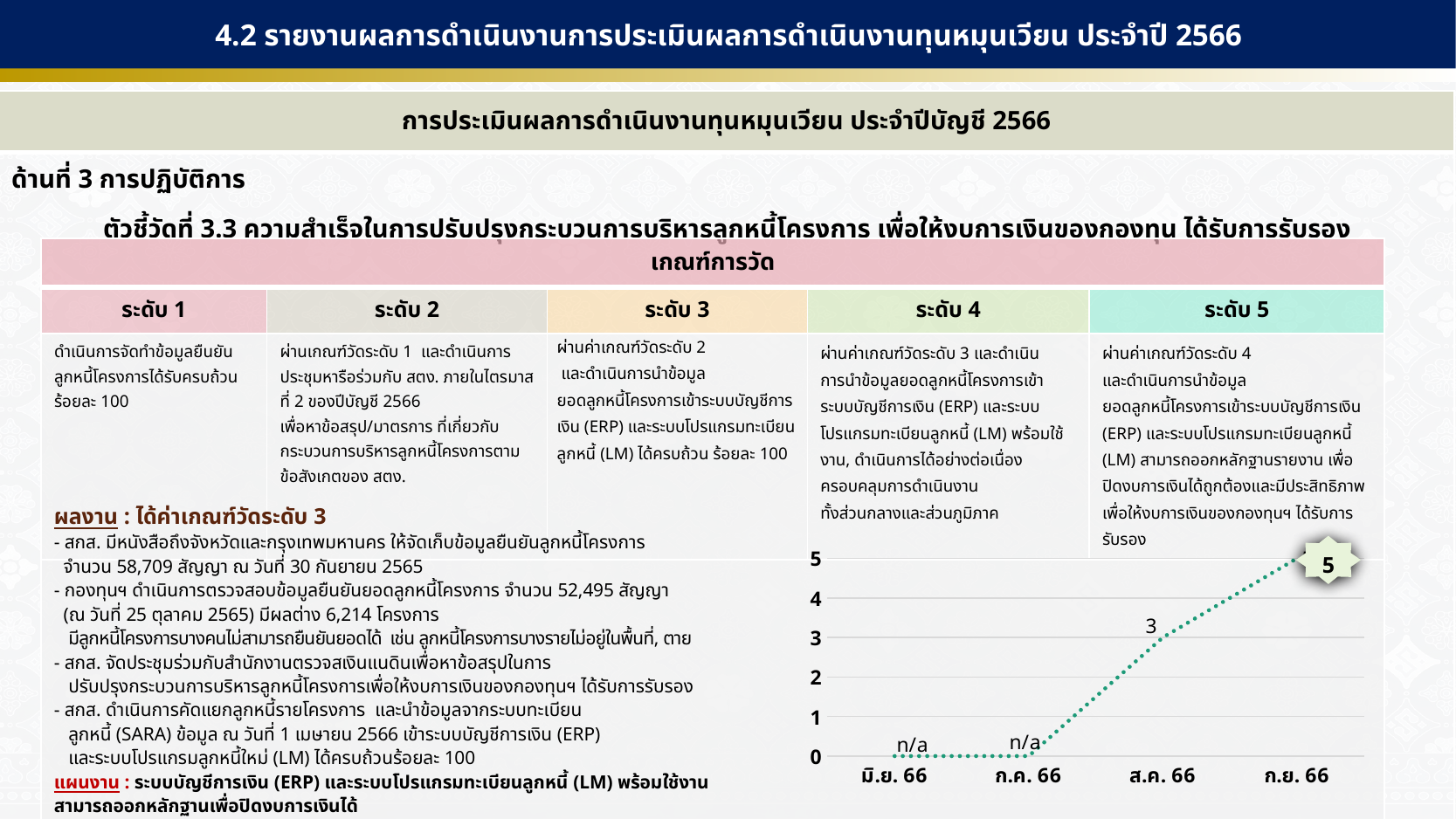
What is the difference between the values for ก.ย. 66 and ส.ค. 66? 2 What is the highest tick value shown on the y axis of the chart? 5 What is the value plotted for ก.ย. 66? 5 What kind of chart is shown at the bottom right of the slide? line chart What label is shown for ก.ค. 66 on the chart? n/a Is the value for ส.ค. 66 greater or less than 2? greater Do the plotted values rise or fall from ส.ค. 66 to ก.ย. 66? rise Which is larger, the value for ส.ค. 66 or the value for ก.ย. 66? ก.ย. 66 How many categories are shown on the x axis of the chart? 4 What label is shown for มิ.ย. 66 on the chart? n/a Which month has the highest plotted value on the chart? ก.ย. 66 What is the value plotted for ส.ค. 66? 3